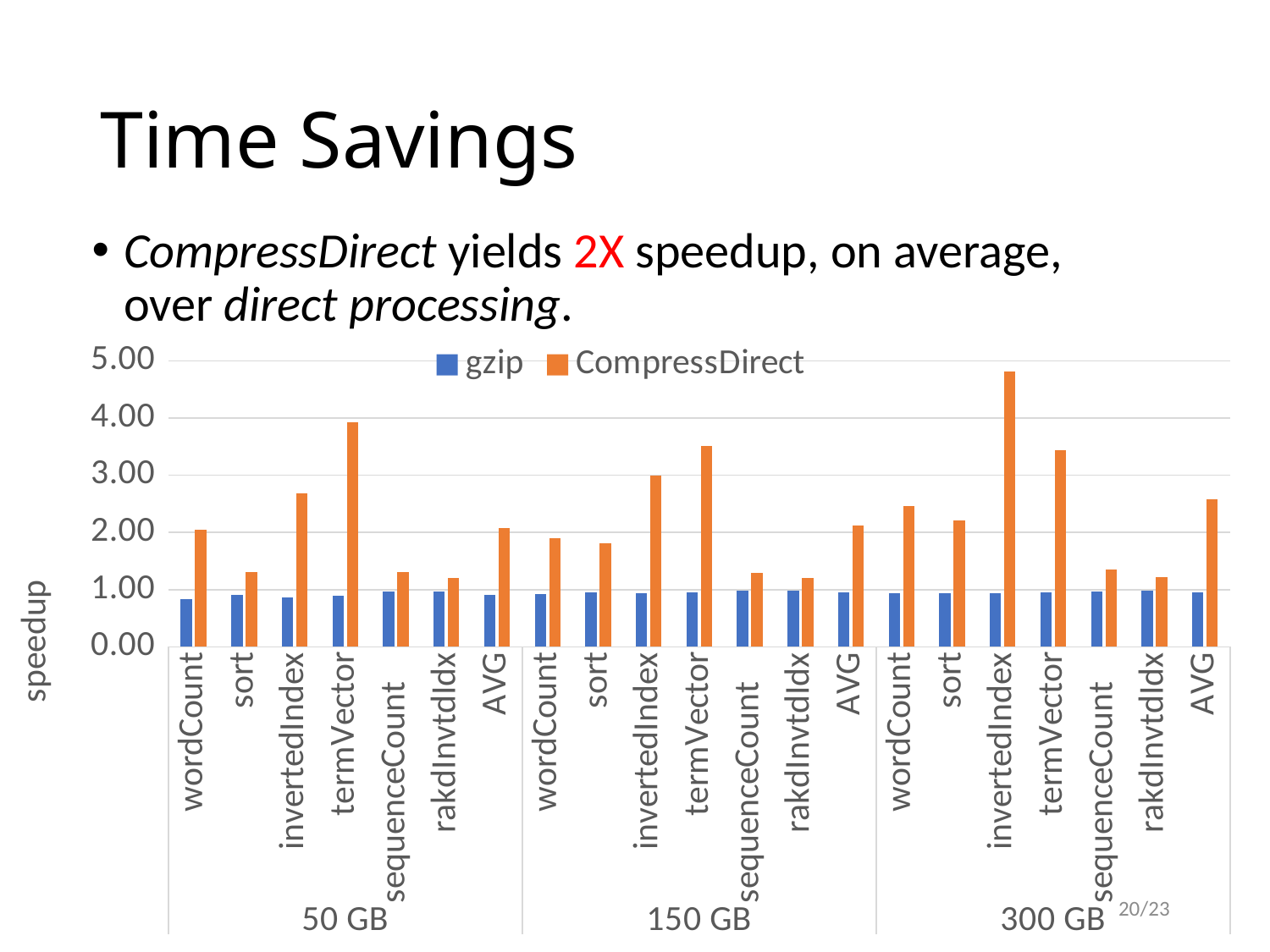
How many data-size groups are shown along the x axis of the chart? 3 Is the CompressDirect value for termVector in the 50 GB group greater or less than 3.00? greater Which two series are listed in the chart legend? gzip and CompressDirect Is the CompressDirect value for AVG in the 300 GB group greater or less than 2.00? greater How many series does the chart legend list? 2 Is the gzip value for wordCount in the 50 GB group greater or less than 1.00? less How many categories are plotted within each data-size group (e.g. 50 GB)? 7 What is the label on the vertical axis of the chart? speedup In the 300 GB group, which has the larger CompressDirect value: invertedIndex or termVector? invertedIndex For which category and group is the CompressDirect bar the highest? invertedIndex, 300 GB What kind of chart is shown on the slide? bar chart